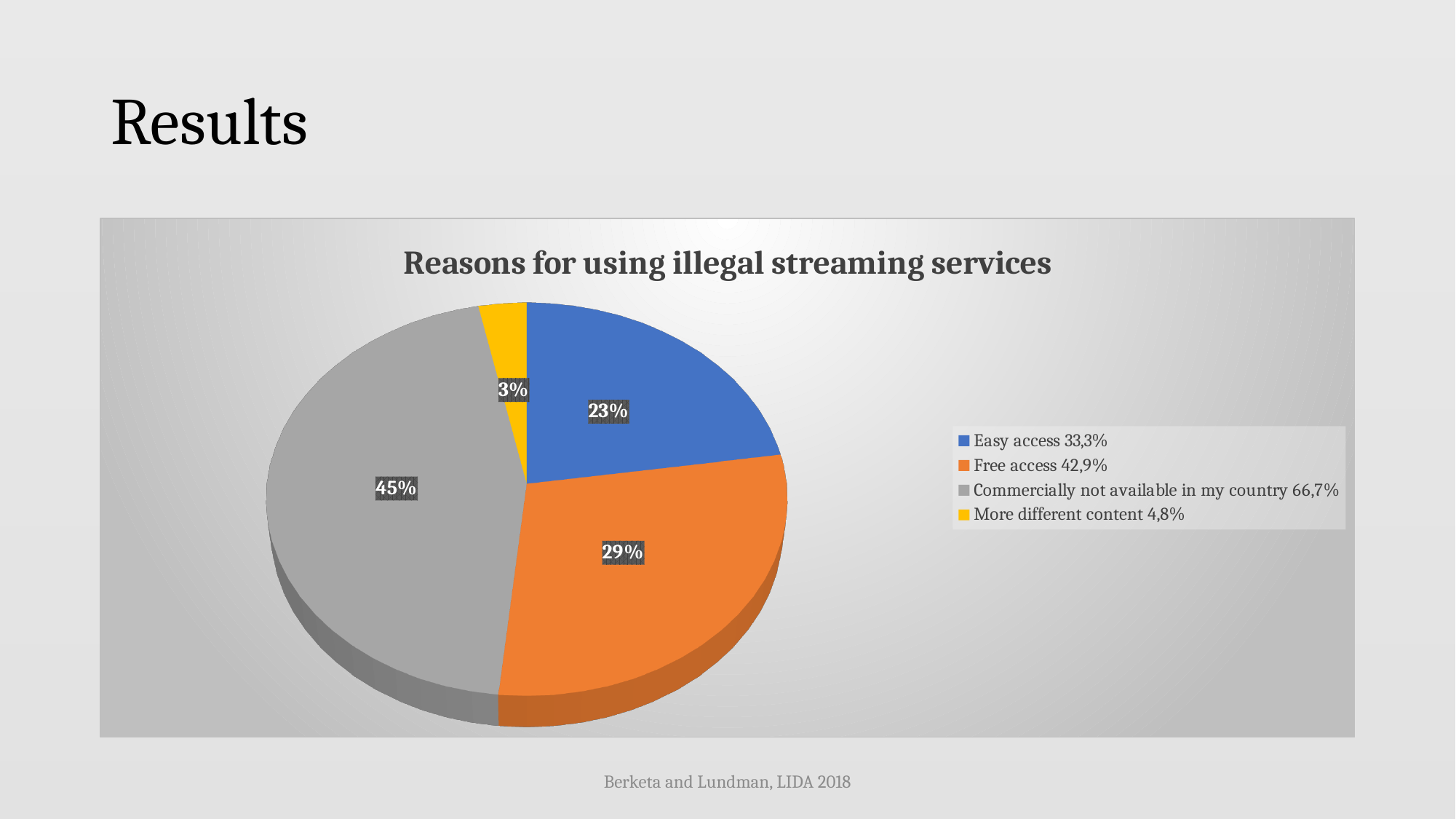
What type of chart is shown on the slide? pie chart What share of the pie is labelled for the Commercially not available in my country slice? 45% Which category has the largest slice of the pie? Commercially not available in my country What share of the pie is labelled for the Easy access slice? 23% What share of the pie is labelled for the More different content slice? 3% What share of the pie is labelled for the Free access slice? 29% Which slice is larger, Easy access or Free access? Free access What percentage is printed next to Easy access in the legend? 33,3% What is the title of the chart? Reasons for using illegal streaming services Which category has the smallest slice of the pie? More different content What is the difference in percentage points between the Commercially not available in my country slice and the Free access slice? 16 How many slices does the pie chart have? 4